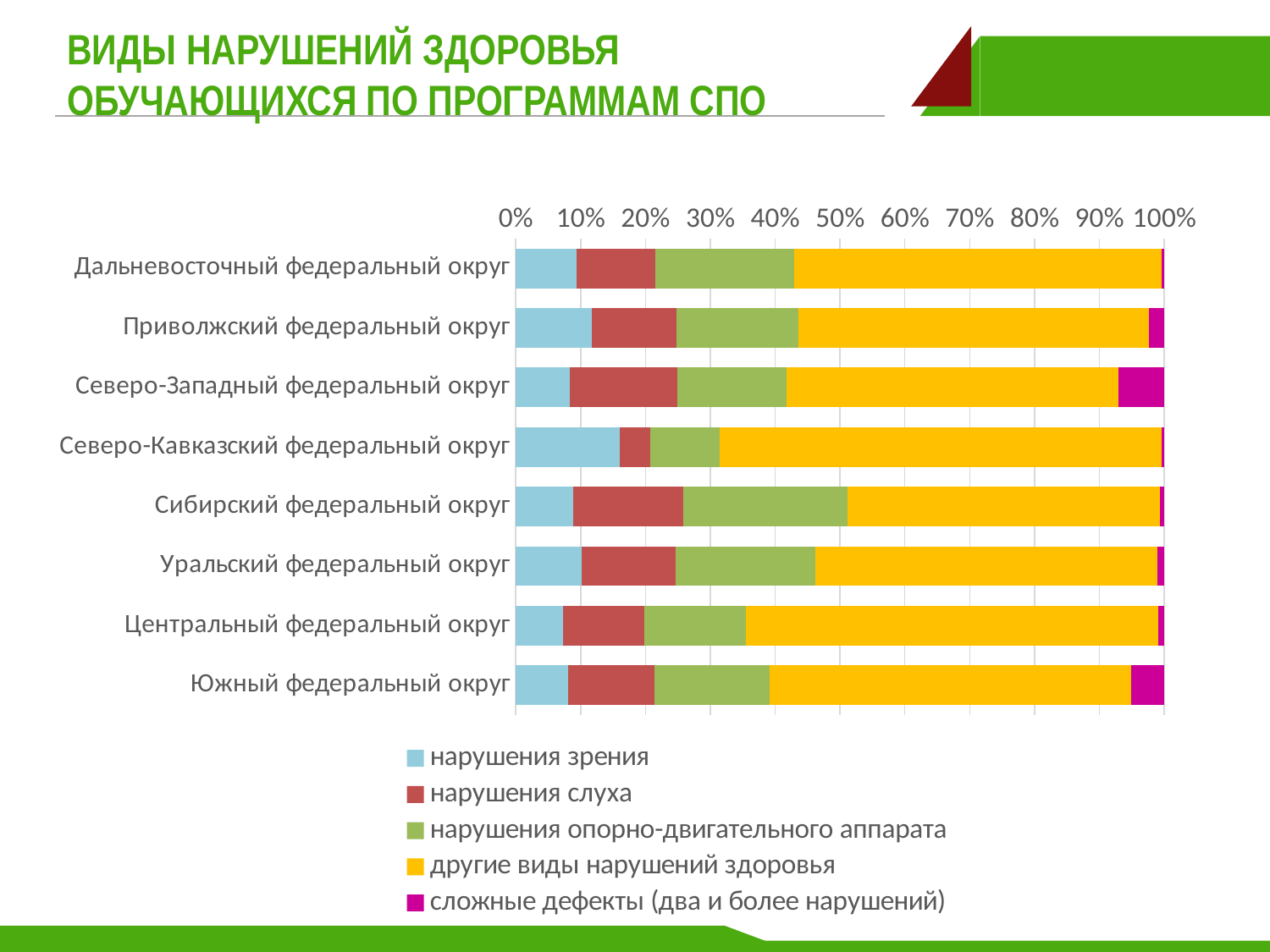
What is the title of the slide containing the chart? ВИДЫ НАРУШЕНИЙ ЗДОРОВЬЯ ОБУЧАЮЩИХСЯ ПО ПРОГРАММАМ СПО Which federal district has the largest share of 'сложные дефекты (два и более нарушений)' (magenta segment)? Северо-Западный федеральный округ Which federal district has the largest share of 'нарушения зрения' (blue segment)? Северо-Кавказский федеральный округ What does each stacked bar total on the horizontal axis? 100% How many federal districts (categories) are shown on the chart? 8 How many series does the legend list? 5 Which series is shown in yellow according to the legend? другие виды нарушений здоровья What kind of chart is shown on the slide? Stacked bar chart Is the share of 'нарушения зрения' for Центральный федеральный округ greater or less than 10%? less Which has a larger share of 'нарушения зрения': Северо-Кавказский федеральный округ or Центральный федеральный округ? Северо-Кавказский федеральный округ Which federal district has the smallest share of 'нарушения слуха' (red segment)? Северо-Кавказский федеральный округ Is the share of 'нарушения зрения' for Северо-Кавказский федеральный округ greater or less than 10%? greater